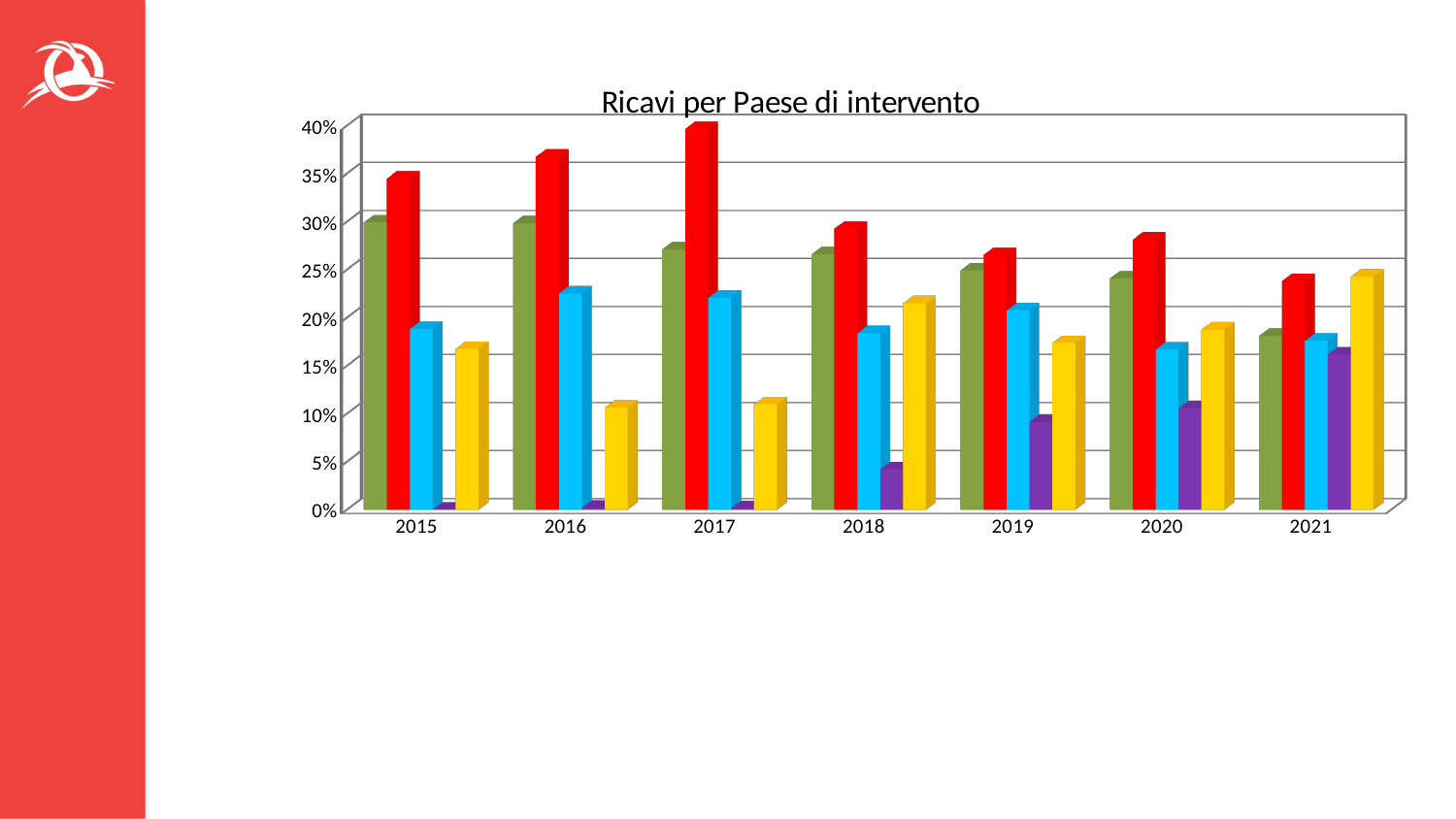
What type of chart is shown on the slide? bar chart In which year is the green bar the shortest? 2021 In which year is the red bar the tallest? 2017 Is the value of the yellow bar for 2016 greater or less than 15%? less Is the value of the red bar for 2017 greater or less than 35%? greater Do the green bars generally rise or fall from 2015 to 2021? fall How many years are shown on the x axis of the chart? 7 What is the title of the chart? Ricavi per Paese di intervento In 2015, which is larger: the red bar or the green bar? the red bar How many bars are plotted for each year in the chart? 5 In 2018, which is larger: the yellow bar or the blue bar? the yellow bar